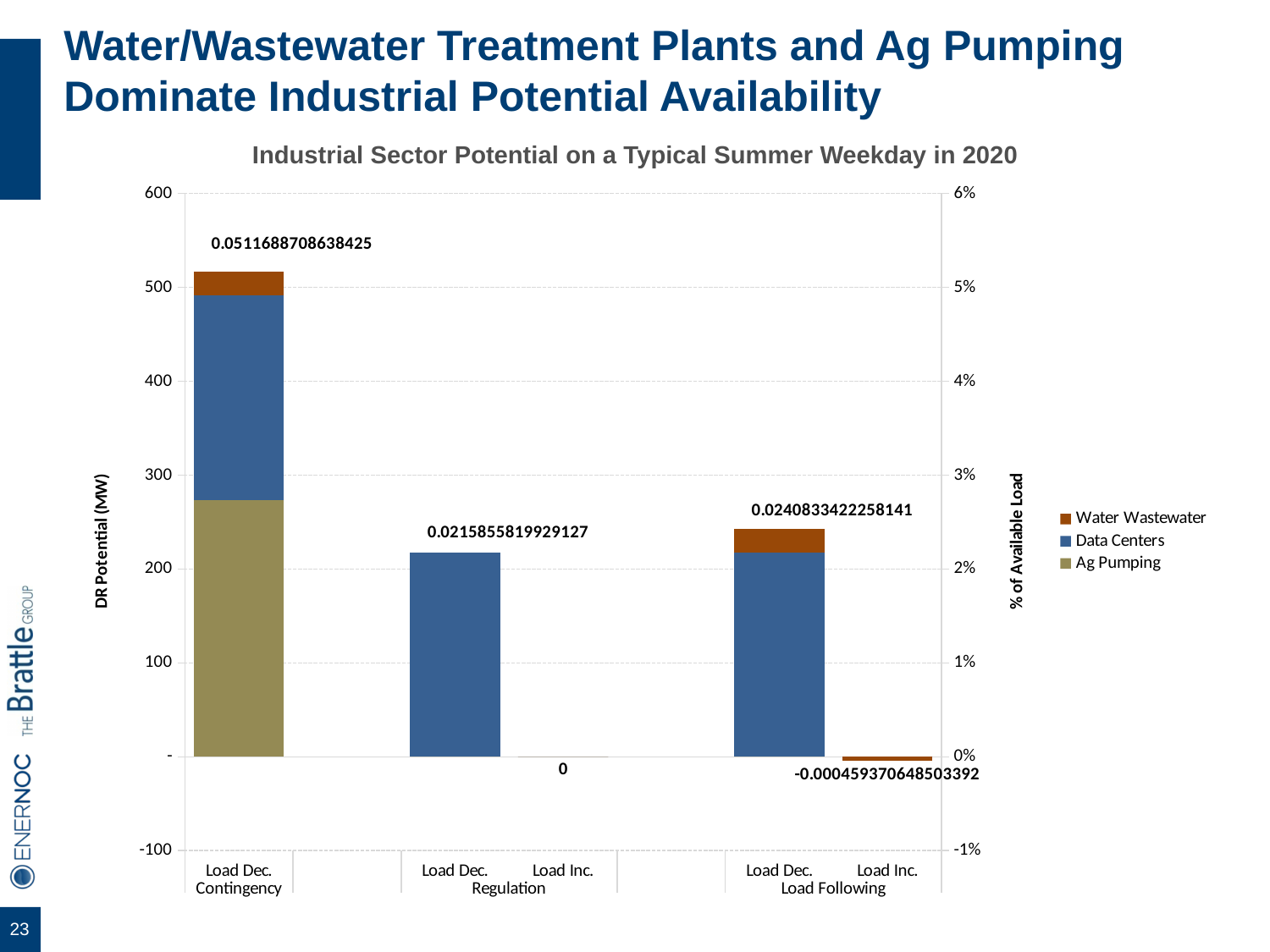
What kind of chart is shown on the slide? Stacked bar chart Which is larger, the labeled value for Load Dec. Load Following or for Load Dec. Regulation? Load Dec. Load Following Which category has the tallest stacked bar? Load Dec. Contingency What is the title of the chart? Industrial Sector Potential on a Typical Summer Weekday in 2020 Which category has the lowest value? Load Inc. Load Following What is the data label shown above the Load Dec. Contingency bar? 0.0511688708638425 Is the total DR Potential (MW) for Load Dec. Contingency greater or less than 500? greater What is the data label shown for Load Inc. Load Following? -0.000459370648503392 How many series does the legend list? 3 What is the data label shown above the Load Dec. Regulation bar? 0.0215855819929127 Which series are listed in the legend? Water Wastewater, Data Centers, Ag Pumping What is the data label shown for Load Inc. Regulation? 0